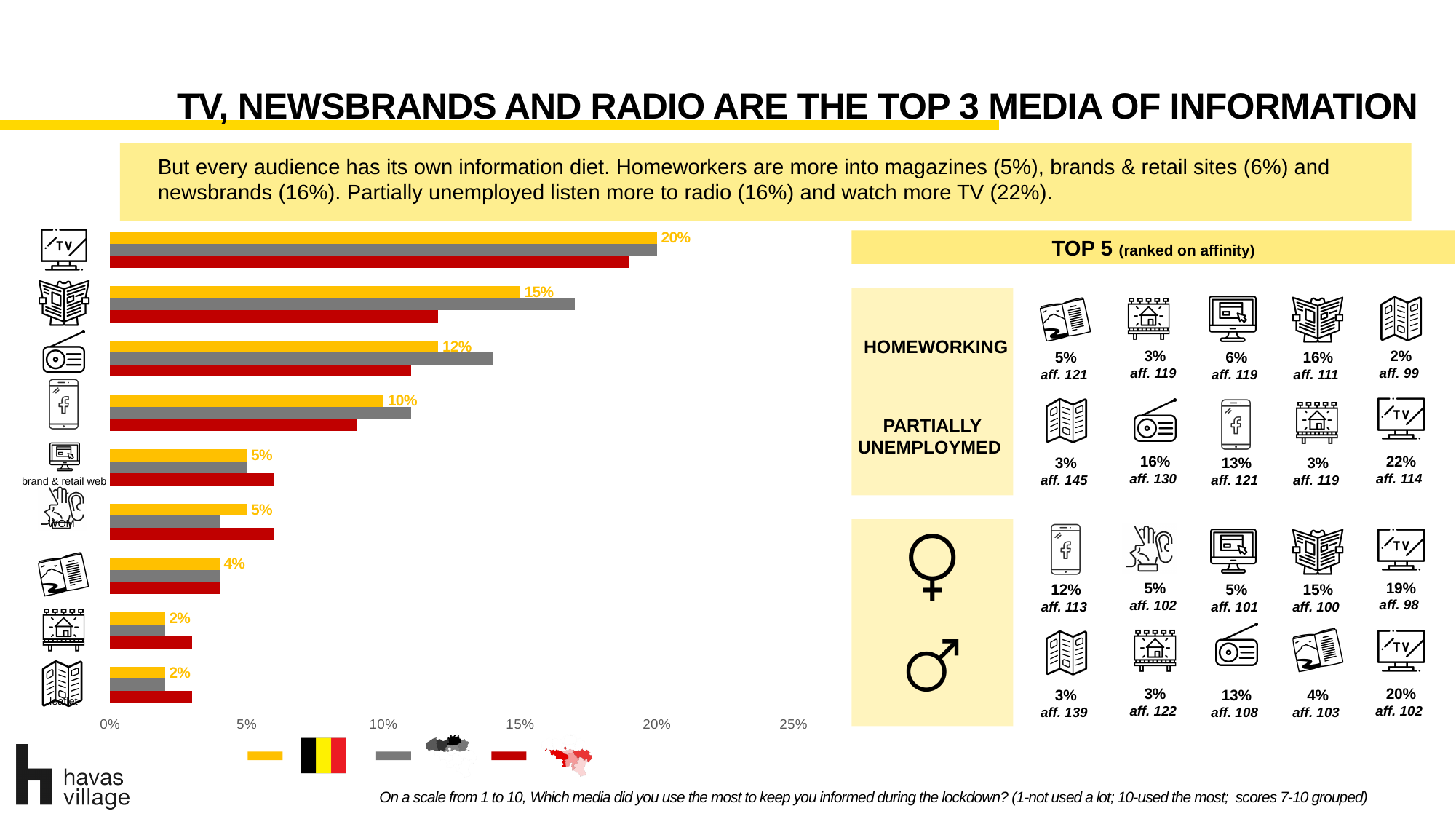
How many media categories are plotted in the bar chart? 9 What is the labelled value of the yellow bar for the bottom category (leaflet)? 2% What is the labelled value of the yellow bar for the 'brand & retail web' category? 5% What kind of chart is shown on the left of the slide? bar chart What is the difference between the yellow-bar values of the top category (TV, 20%) and the second category (15%)? 5% What is the labelled value of the yellow bar for the TV category? 20% How many series (colours) does the bar chart's legend show? 3 Is the grey bar for the 'brand & retail web' category greater or less than 10%? less Do the yellow-bar values rise or fall going from the top category to the bottom category? fall Is the grey bar for the TV category greater or less than 15%? greater Which category has the highest yellow-bar value in the bar chart? TV Which is larger: the yellow bar for TV or the yellow bar for 'brand & retail web'? TV